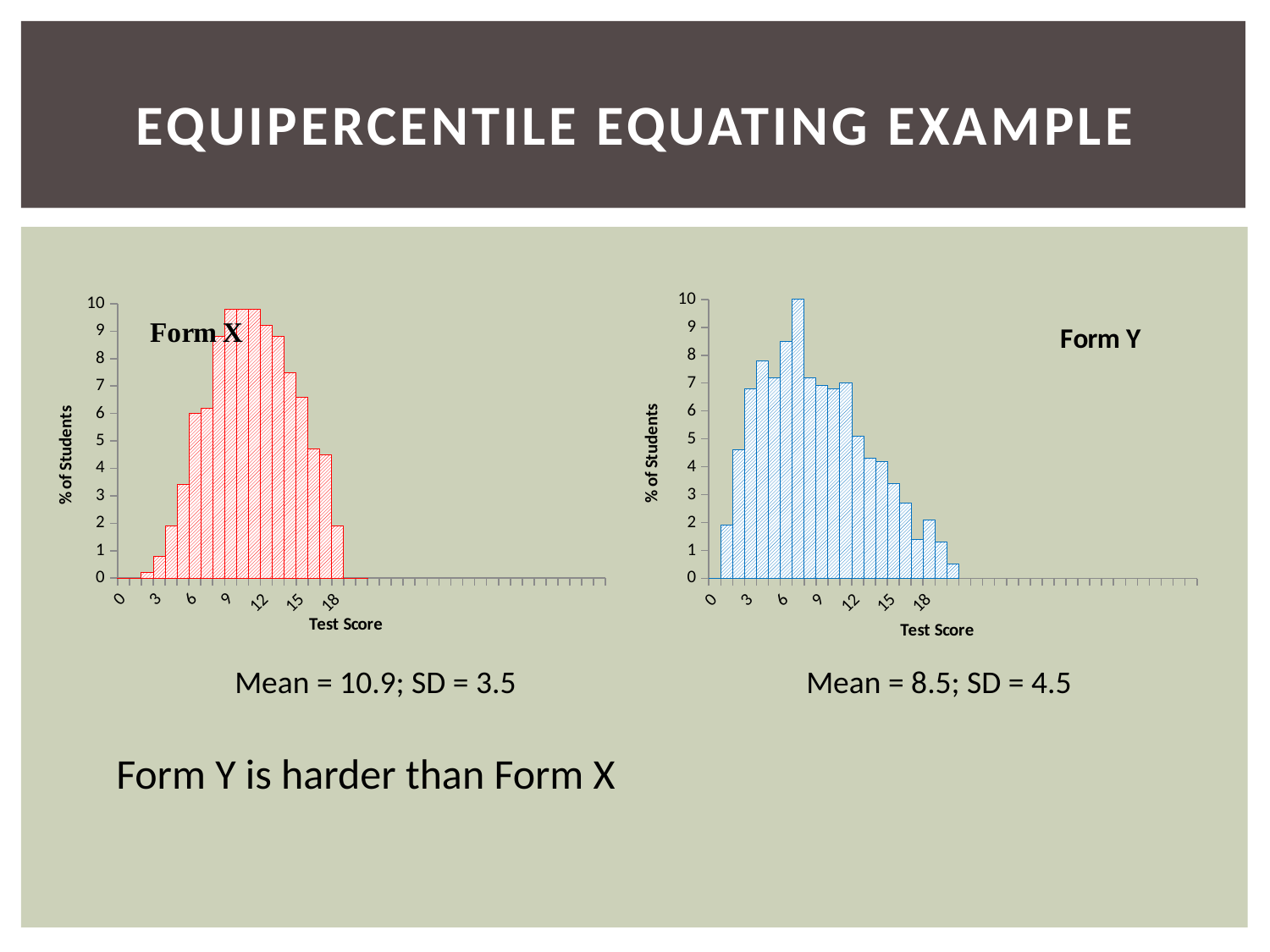
In the Form Y chart, is the value for test score 15 greater or less than 4? less In the Form X chart, do the values rise or fall as the test score goes from 12 to 18? fall In the Form Y chart, is the value for test score 7 greater or less than 9? greater In the Form Y chart on the right, which test score has the highest percentage of students? 7 In the Form Y chart, is the value for test score 2 greater or less than 5? less What kind of chart is the Form X chart on the left? bar chart In the Form X chart, which has a larger percentage of students: test score 9 or test score 3? test score 9 What is the y-axis title of the Form Y chart? % of Students What is the x-axis title of the Form X chart? Test Score In the Form Y chart, which has a larger percentage of students: test score 7 or test score 4? test score 7